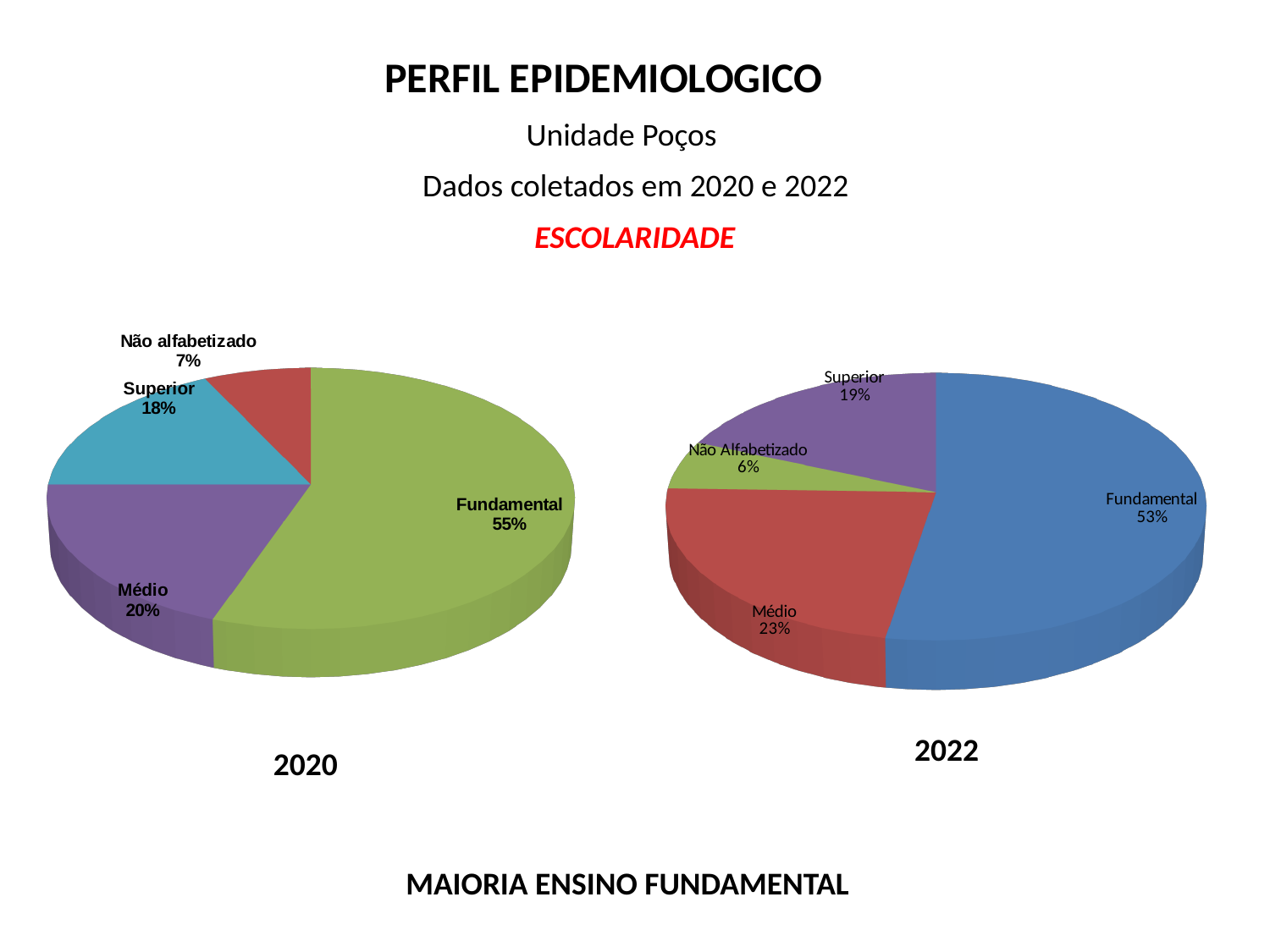
In the 2022 pie chart, what share does Não Alfabetizado have? 6% In the 2020 pie chart, what share does Fundamental have? 55% In the 2022 pie chart, what share does Médio have? 23% In the 2020 pie chart, what is the difference in percentage points between Fundamental and Médio? 35 What kind of chart is the 2022 chart? Pie chart In the 2020 pie chart, which category has the largest share? Fundamental How many categories does the 2020 pie chart show? 4 In the 2020 pie chart, what share does Superior have? 18% What colour is the Fundamental slice in the 2022 pie chart? Blue In the 2022 pie chart, which is larger, Médio or Superior? Médio In the 2022 pie chart, which category has the smallest share? Não Alfabetizado In the 2022 pie chart, what is the difference in percentage points between Superior and Não Alfabetizado? 13